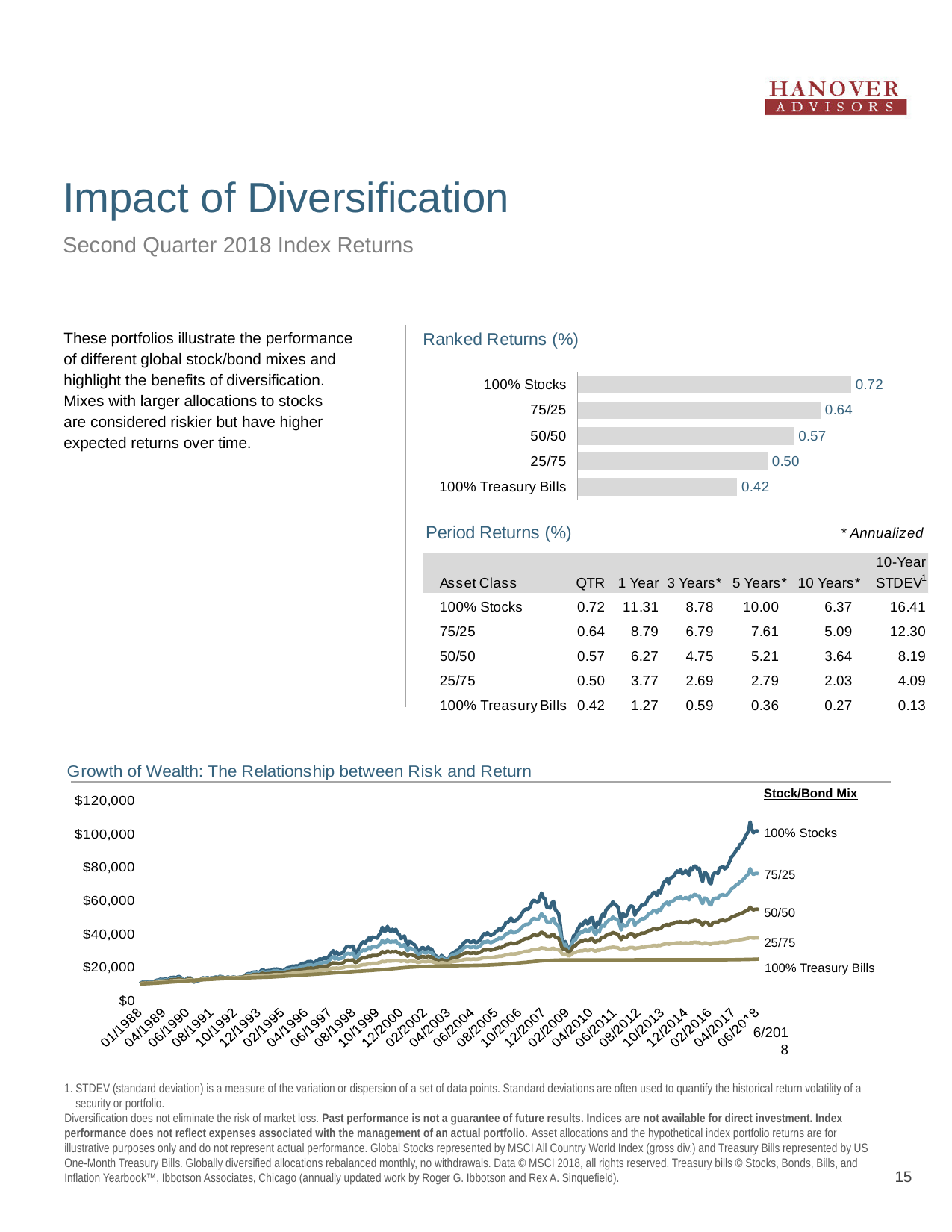
In the Ranked Returns (%) chart, what is the value for 50/50? 0.57 How many categories are shown in the Ranked Returns (%) chart? 5 In the Ranked Returns (%) chart, which is larger, the value for 50/50 or the value for 25/75? 50/50 In the Growth of Wealth chart, is the ending value of the 100% Stocks line greater or less than $80,000? greater In the Ranked Returns (%) chart, what is the difference between the values for 75/25 and 25/75? 0.14 In the Ranked Returns (%) chart, what is the value for 100% Stocks? 0.72 What kind of chart is the Growth of Wealth: The Relationship between Risk and Return chart? Line chart In the Ranked Returns (%) chart, what is the value for 100% Treasury Bills? 0.42 In the Ranked Returns (%) chart, which category has the highest value? 100% Stocks In the Ranked Returns (%) chart, which category has the lowest value? 100% Treasury Bills What kind of chart is the Ranked Returns (%) chart? Bar chart In the Growth of Wealth chart, how many stock/bond mix series are plotted? 5